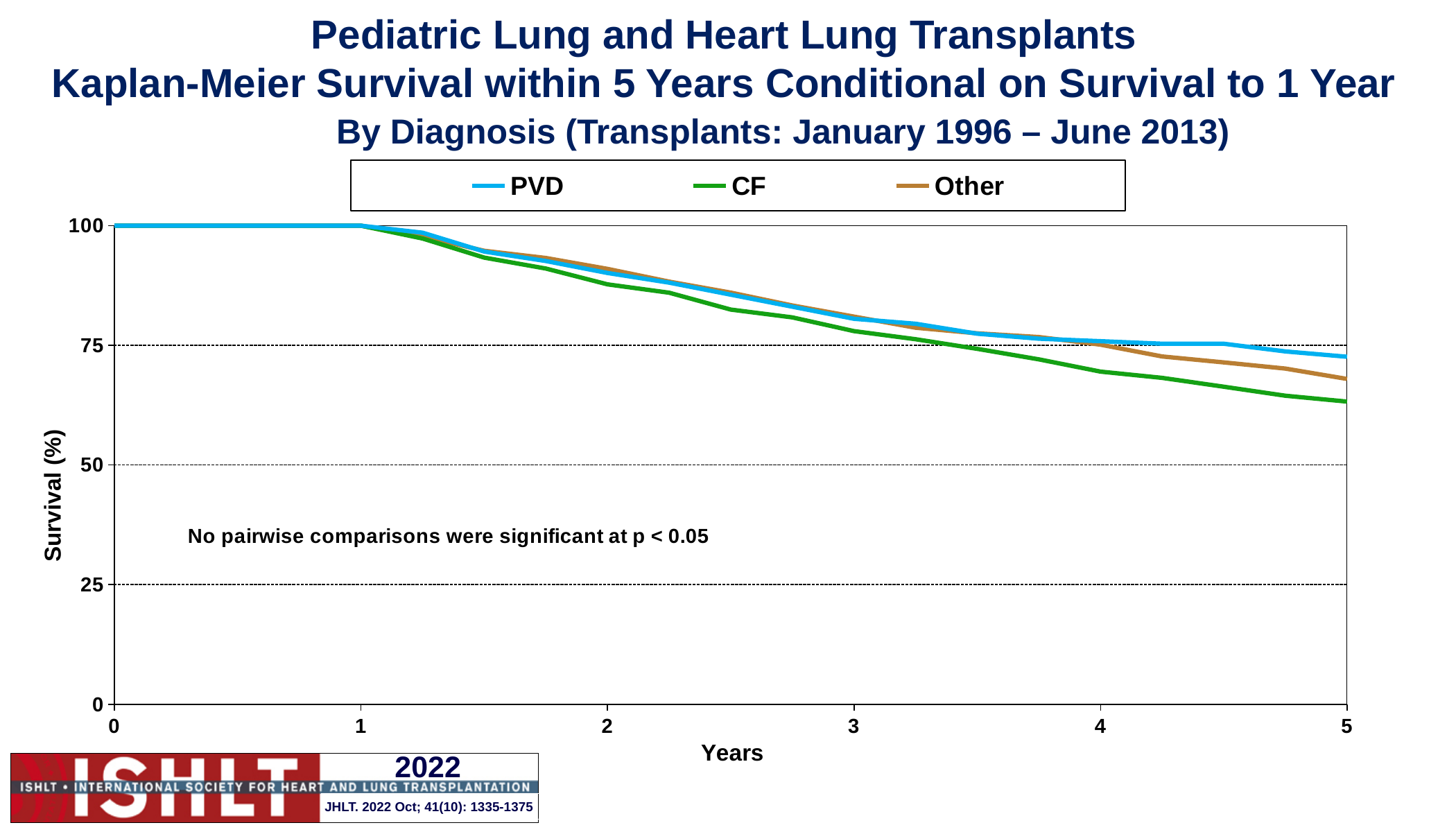
Is the survival value for CF at 2 years greater or less than 75? greater What is the survival value for all three groups at 1 year? 100 How many series does the legend list? 3 At 5 years, which group has the lowest survival? CF At 5 years, which has higher survival, PVD or CF? PVD What kind of chart is shown on the slide? Line chart Is the survival value for CF at 5 years greater or less than 75? less Which diagnosis groups are listed in the legend? PVD, CF, Other At 5 years, which group has the highest survival? PVD Is the survival value for PVD at 3 years greater or less than 75? greater Do the survival curves rise or fall as years increase from 1 to 5? Fall